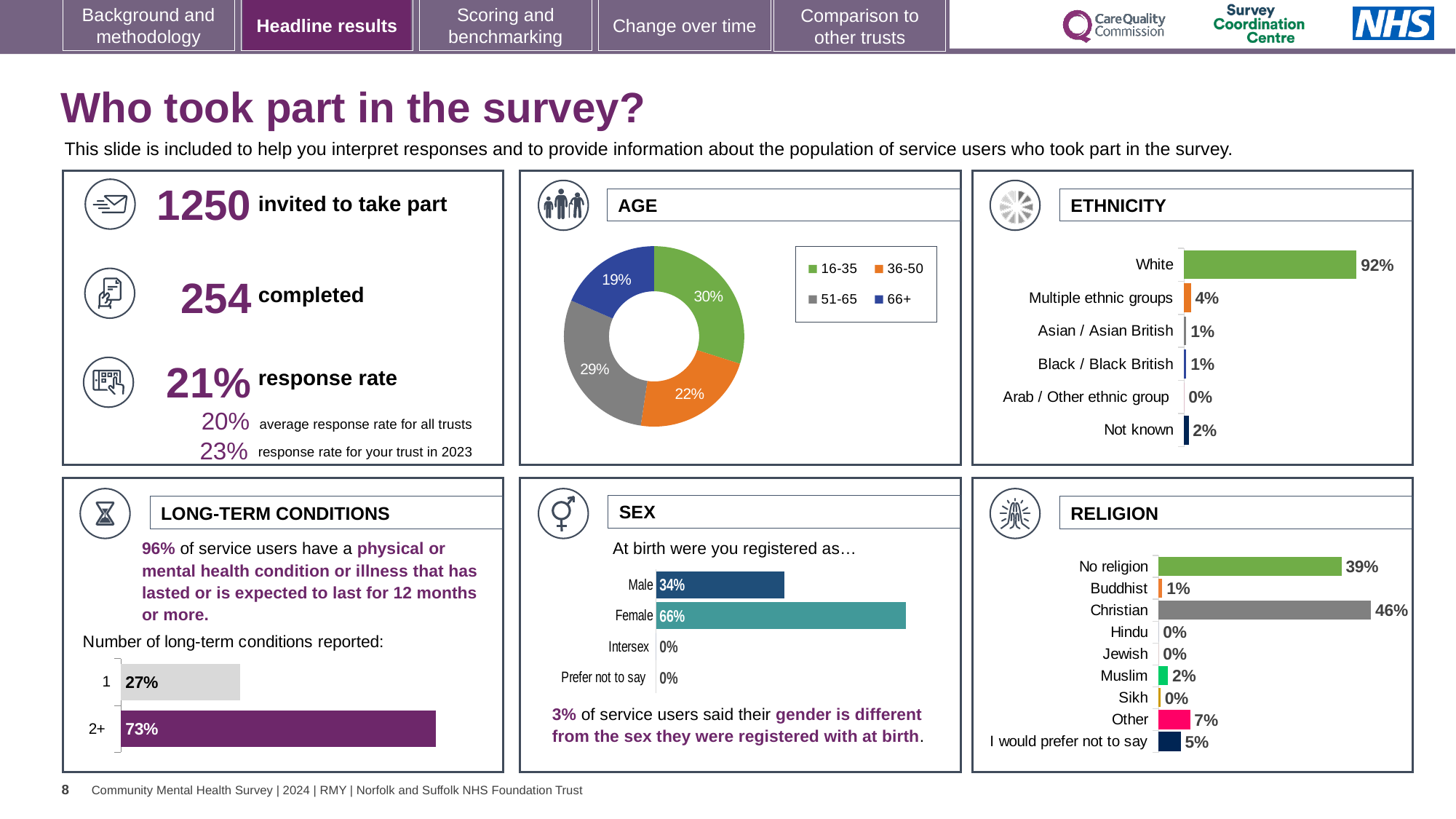
In the ETHNICITY chart, what is the difference between White and Not known? 90% How many entries does the legend of the AGE chart list? 4 What kind of chart is the AGE chart? Donut chart In the SEX chart, which is larger, Male or Female? Female In the RELIGION chart, what is the value for Other? 7% In the LONG-TERM CONDITIONS chart, what percentage of service users reported 2+ long-term conditions? 73% In the AGE chart, what share of respondents are aged 16-35? 30% In the ETHNICITY chart, what is the value for Multiple ethnic groups? 4% How many categories are shown in the ETHNICITY chart? 6 In the AGE chart, which age group has the smallest share? 66+ In the SEX chart, what is the difference between Female and Male? 32% In the RELIGION chart, which category has the highest value? Christian